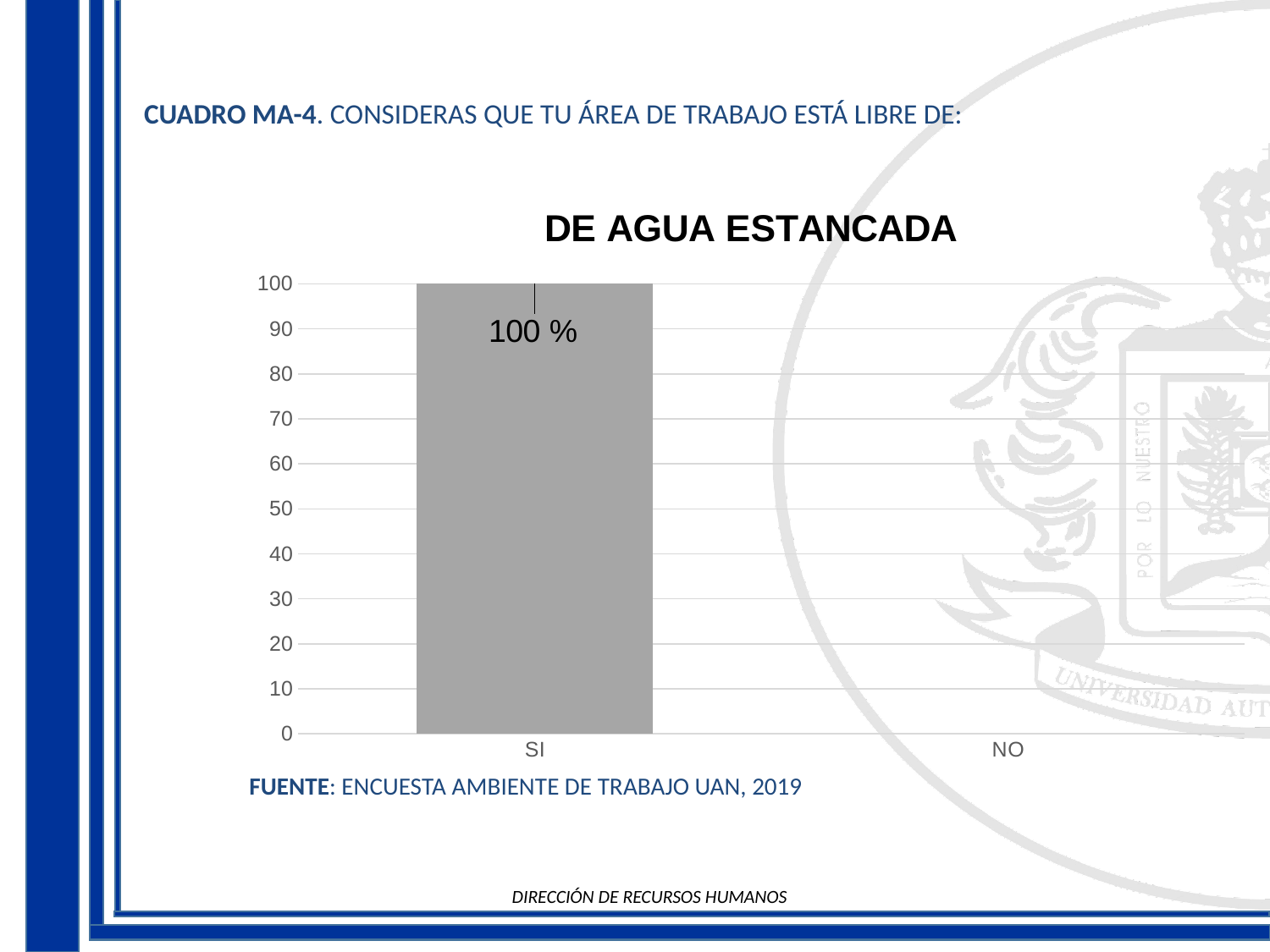
Which category has the larger value, SI or NO? SI Is the value for SI greater or less than 50? greater What are the category labels on the x axis of the chart? SI and NO What is the highest value shown on the y axis of the chart? 100 Which category has the lowest value in the chart? NO What is the title of the chart? DE AGUA ESTANCADA What value is shown for the SI category in the DE AGUA ESTANCADA chart? 100 % How many categories are shown on the x axis of the chart? 2 What type of chart is used on this slide? bar chart Which category has the highest value in the chart? SI